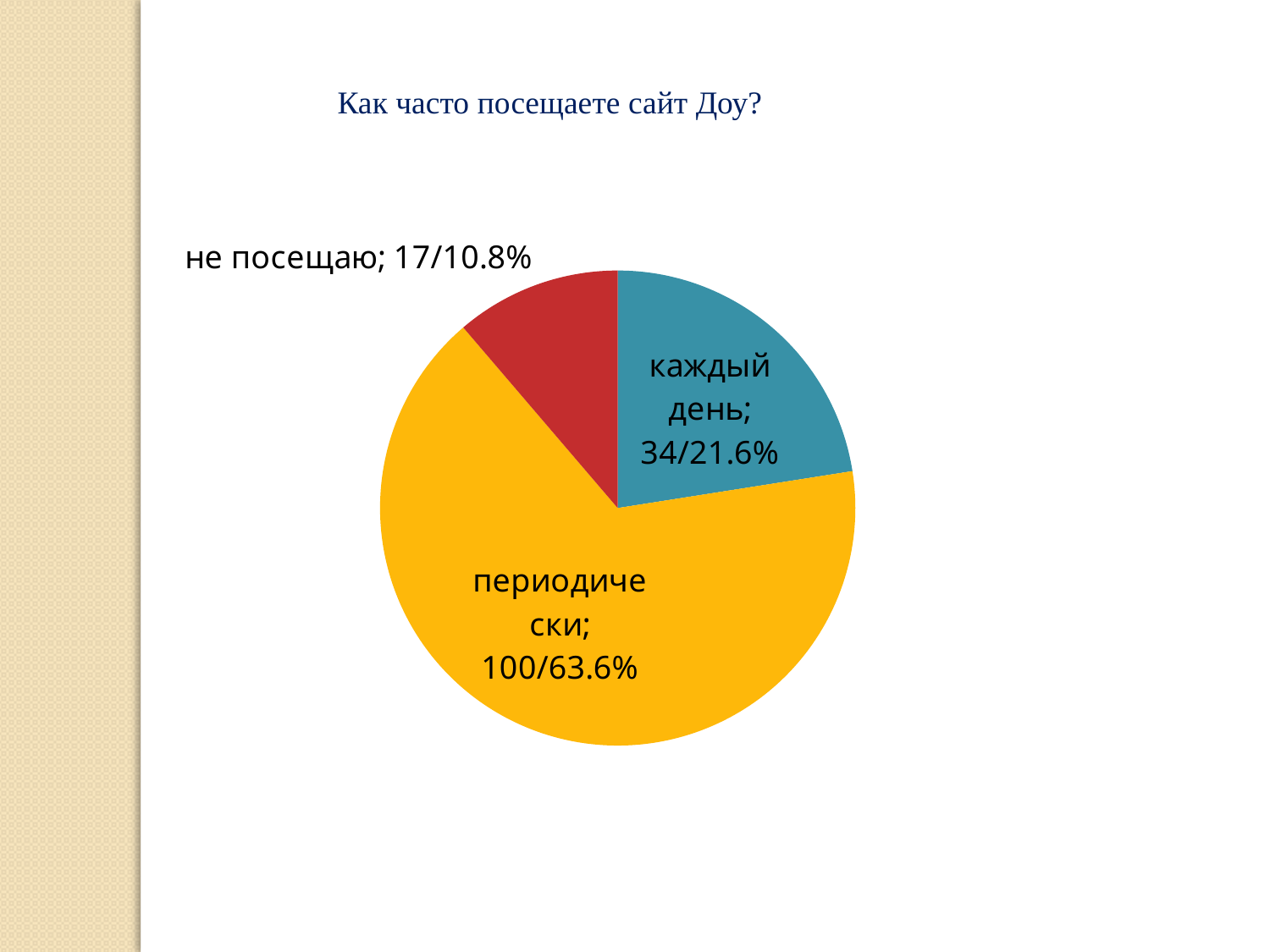
Which slice is the largest? периодически What value is shown for the slice "не посещаю"? 17/10.8% How many slices does the pie chart have? 3 What value is shown for the slice "каждый день"? 34/21.6% Which slice is the smallest? не посещаю What is the title of the chart? Как часто посещаете сайт Доу? Which is larger, the count for "каждый день" or for "не посещаю"? каждый день What colour is the slice for "периодически"? yellow What value is shown for the slice "периодически"? 100/63.6% What kind of chart is shown on the slide? pie chart What is the difference between the counts for "периодически" and "каждый день"? 66 What percentage share of the pie does "каждый день" have? 21.6%